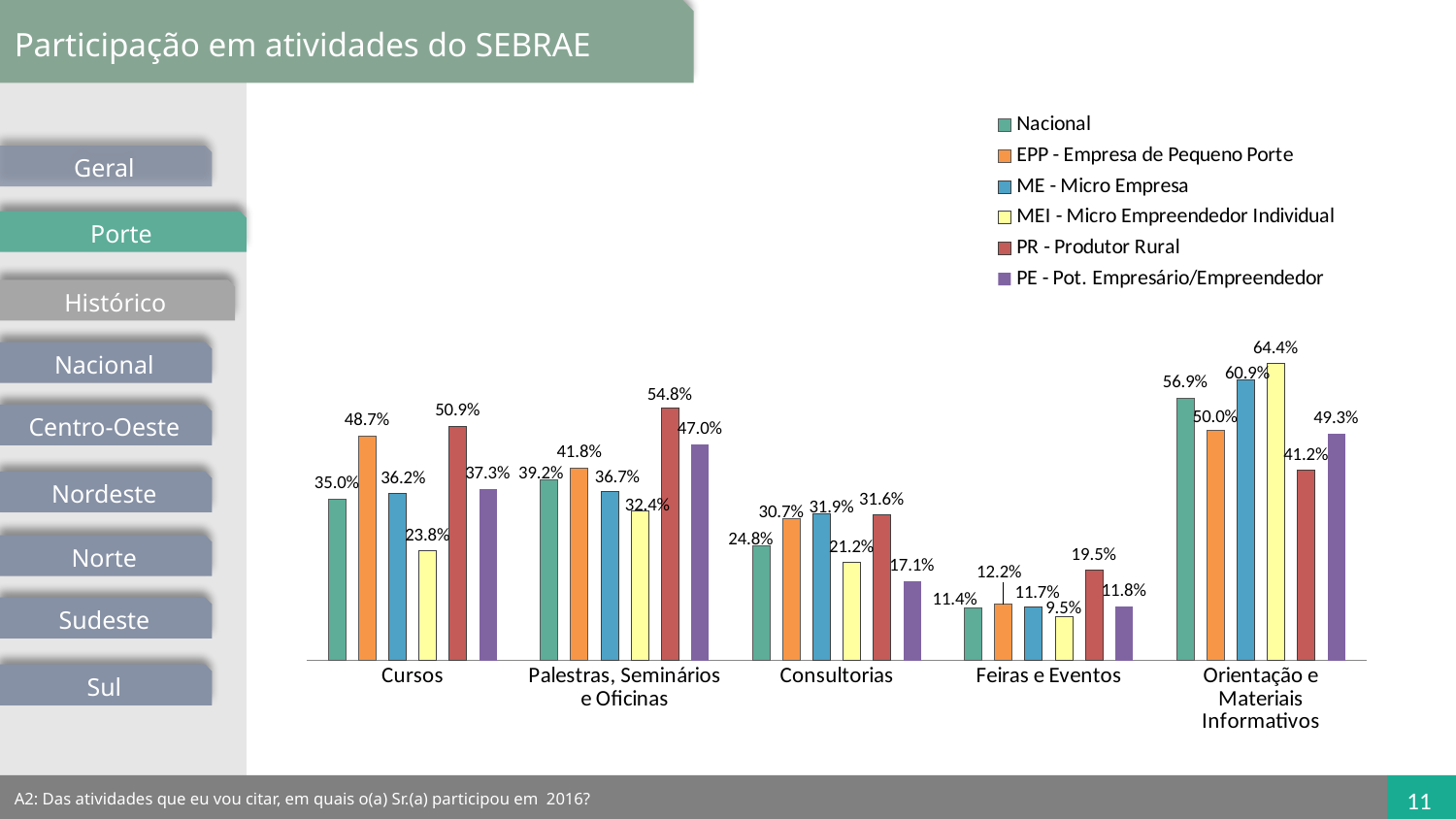
What is the value for MEI - Micro Empreendedor Individual in the Orientação e Materiais Informativos category? 64.4% What is the value for PE - Pot. Empresário/Empreendedor in the Consultorias category? 17.1% Which series has the lowest value in the Feiras e Eventos category? MEI - Micro Empreendedor Individual Which series has the highest value in the Palestras, Seminários e Oficinas category? PR - Produtor Rural What is the difference between the MEI and PR values in the Orientação e Materiais Informativos category? 23.2% How many series does the legend list? 6 What is the title of the slide containing the chart? Participação em atividades do SEBRAE What kind of chart is shown on the slide? Bar chart What is the Nacional value for Consultorias? 24.8% In the Cursos category, which is larger: the EPP - Empresa de Pequeno Porte value or the ME - Micro Empresa value? EPP - Empresa de Pequeno Porte What is the value for PR - Produtor Rural in the Cursos category? 50.9% How many activity categories are shown on the x axis? 5